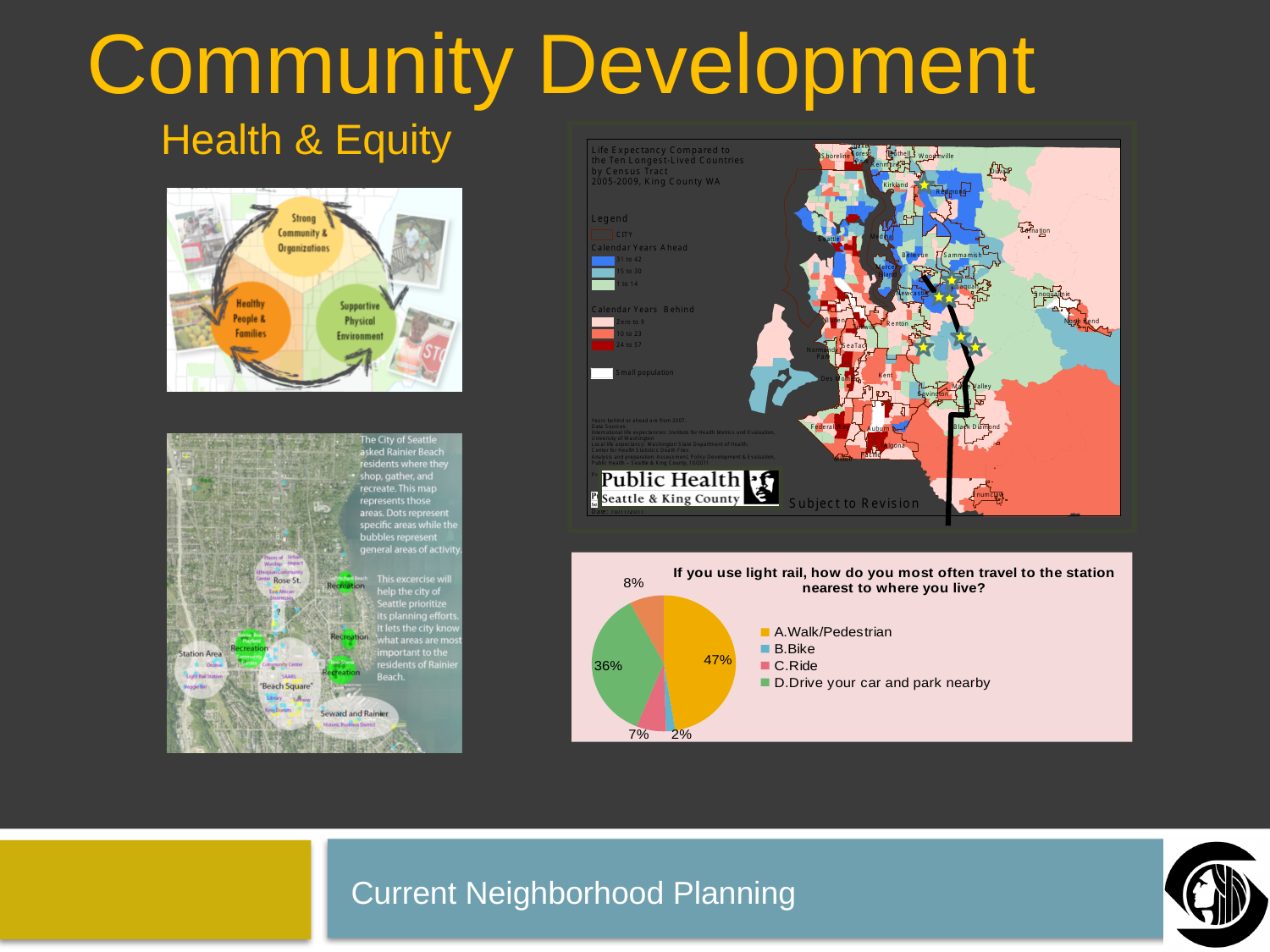
How many percentage labels are shown on the pie chart? 5 In the pie chart, what percentage of respondents chose D.Drive your car and park nearby? 36% How many categories are listed in the pie chart's legend? 4 In the pie chart, which is larger: the share for C.Ride or the share for B.Bike? C.Ride In the pie chart, what percentage of respondents chose A.Walk/Pedestrian? 47% What type of chart is shown at the bottom right of the slide? pie chart What is the title of the pie chart? If you use light rail, how do you most often travel to the station nearest to where you live? In the pie chart, which legend category has the smallest share? B.Bike In the pie chart, what is the difference in percentage points between A.Walk/Pedestrian and D.Drive your car and park nearby? 11% In the pie chart, what percentage of respondents chose B.Bike? 2% In the pie chart, what percentage of respondents chose C.Ride? 7% In the pie chart, which legend category has the largest share? A.Walk/Pedestrian